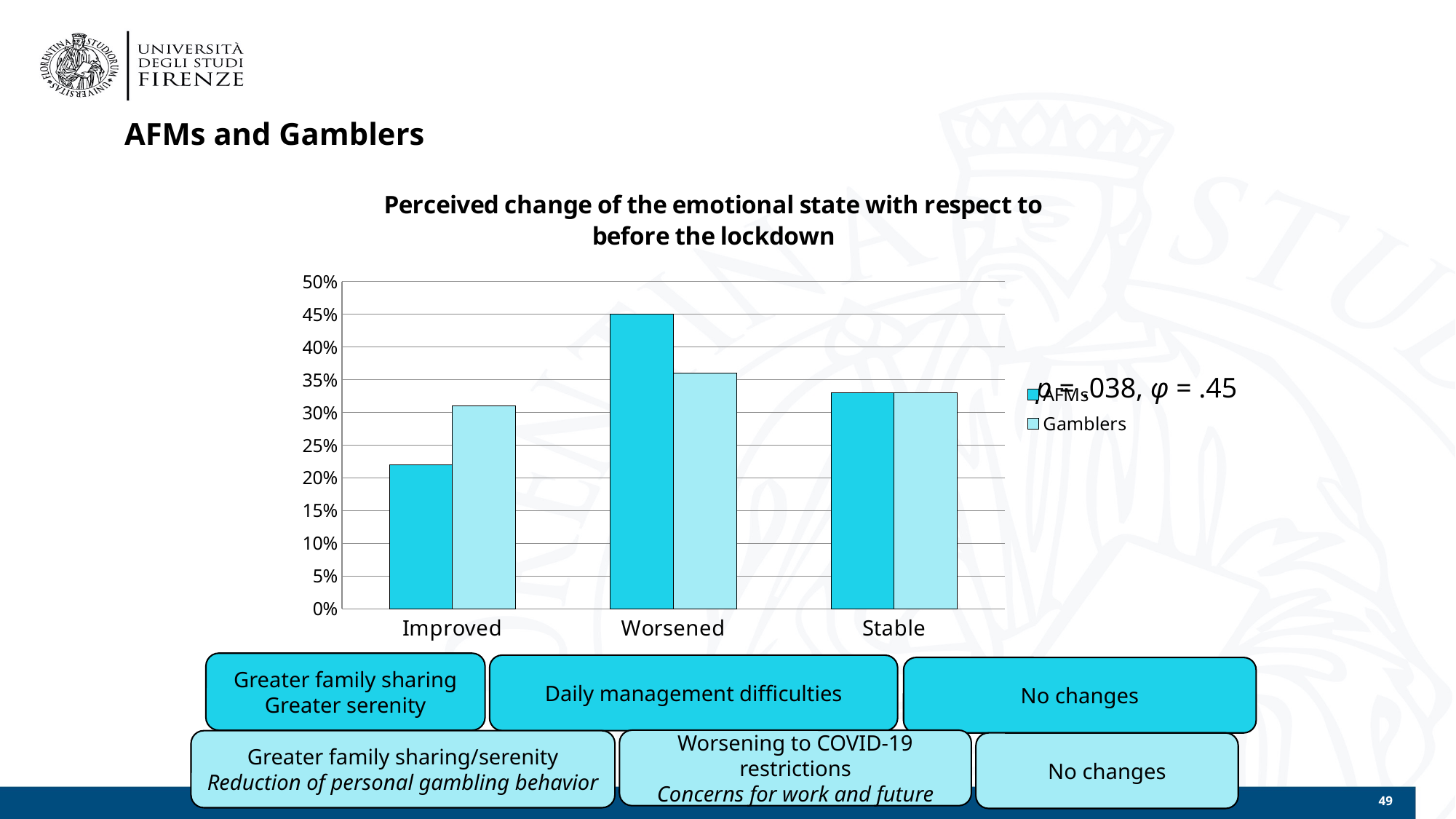
How many series does the legend list? 2 Is the value for AFMs in the Worsened category greater or less than 40%? greater Which category has the lowest value for AFMs? Improved Which category has the highest value for AFMs? Worsened What kind of chart is shown on the slide? bar chart How many categories are shown on the x axis? 3 Is the value for AFMs in the Improved category greater or less than 25%? less Which category has the lowest value for Gamblers? Improved In the Worsened category, which series has the larger value, AFMs or Gamblers? AFMs What is the title of the chart? Perceived change of the emotional state with respect to before the lockdown Which category has the highest value for Gamblers? Worsened